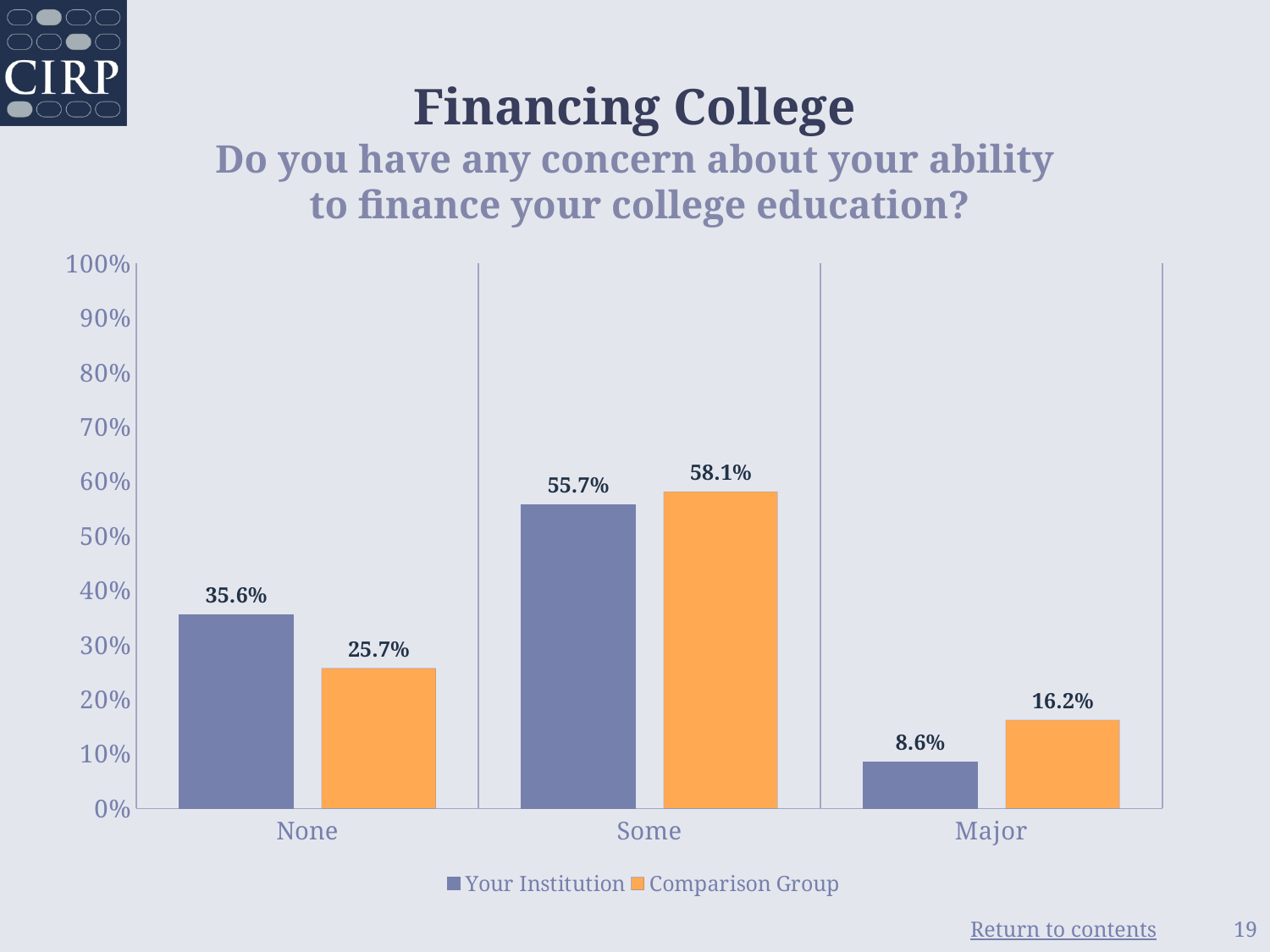
What is the value for Comparison Group in the Some category? 58.1% Which category has the lowest value for Comparison Group? Major In the Major category, which series has the larger value, Your Institution or Comparison Group? Comparison Group What kind of chart is shown on the slide? bar chart Is the value for Your Institution in the Some category greater or less than 50%? greater Which category has the highest value for Your Institution? Some What is the value for Your Institution in the None category? 35.6% What is the difference between Your Institution and Comparison Group in the None category? 9.9% How many series does the legend list? 2 How many categories are shown on the x axis? 3 What is the title of the chart? Financing College What is the value for Comparison Group in the Major category? 16.2%